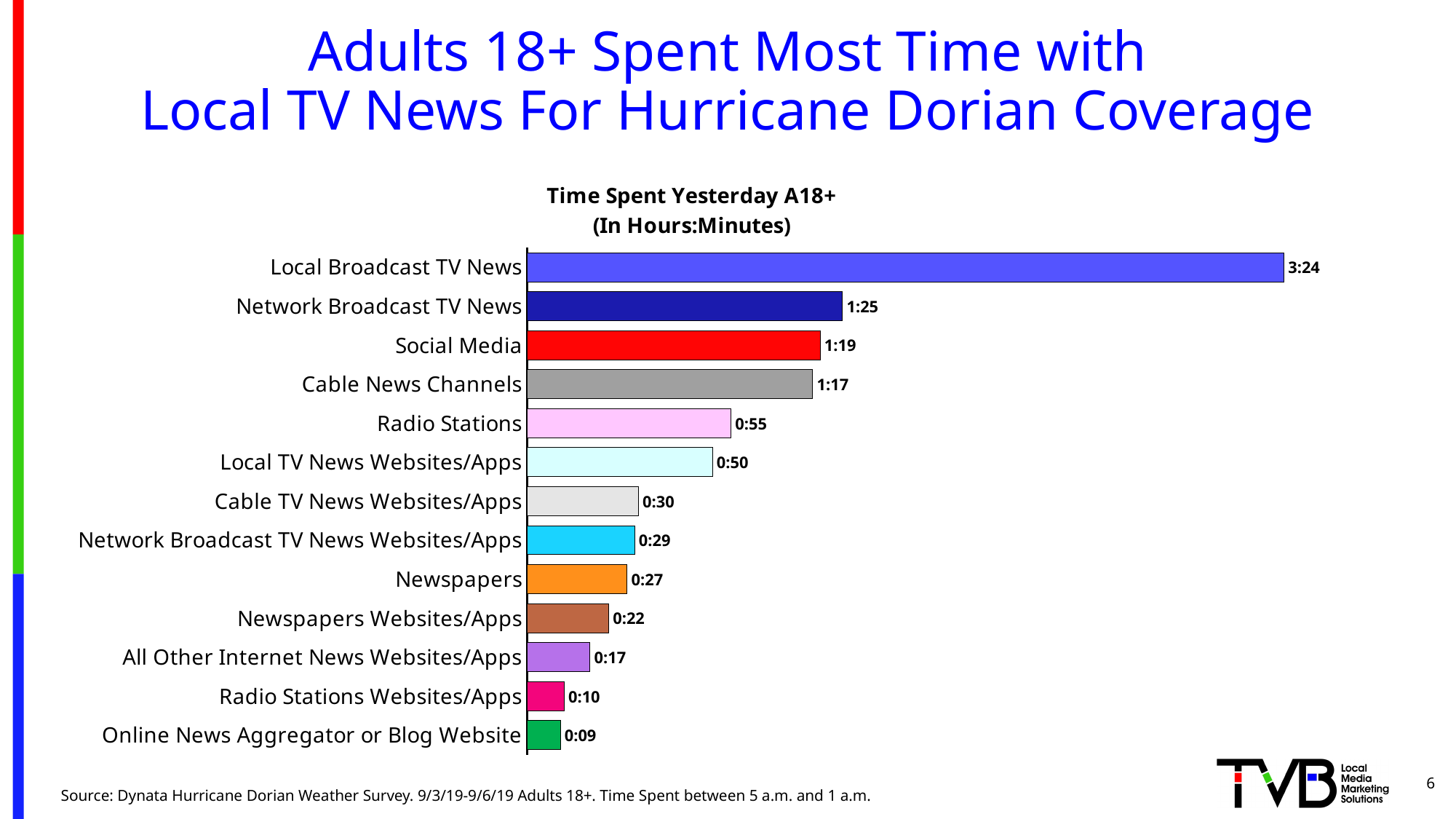
How much more time was spent with Local Broadcast TV News than with Network Broadcast TV News? 1:59 What is the difference in time spent between Radio Stations and Local TV News Websites/Apps? 0:05 What is the time spent yesterday for Radio Stations? 0:55 What is the title of the chart? Time Spent Yesterday A18+ (In Hours:Minutes) How many categories are shown in the chart? 13 Which has a higher time spent, Newspapers or Cable TV News Websites/Apps? Cable TV News Websites/Apps Which has a higher time spent, Social Media or Cable News Channels? Social Media Which category has the highest time spent? Local Broadcast TV News What is the time spent yesterday for Newspapers Websites/Apps? 0:22 What type of chart is shown on the slide? Bar chart Which category has the lowest time spent? Online News Aggregator or Blog Website What is the time spent yesterday for Local Broadcast TV News? 3:24